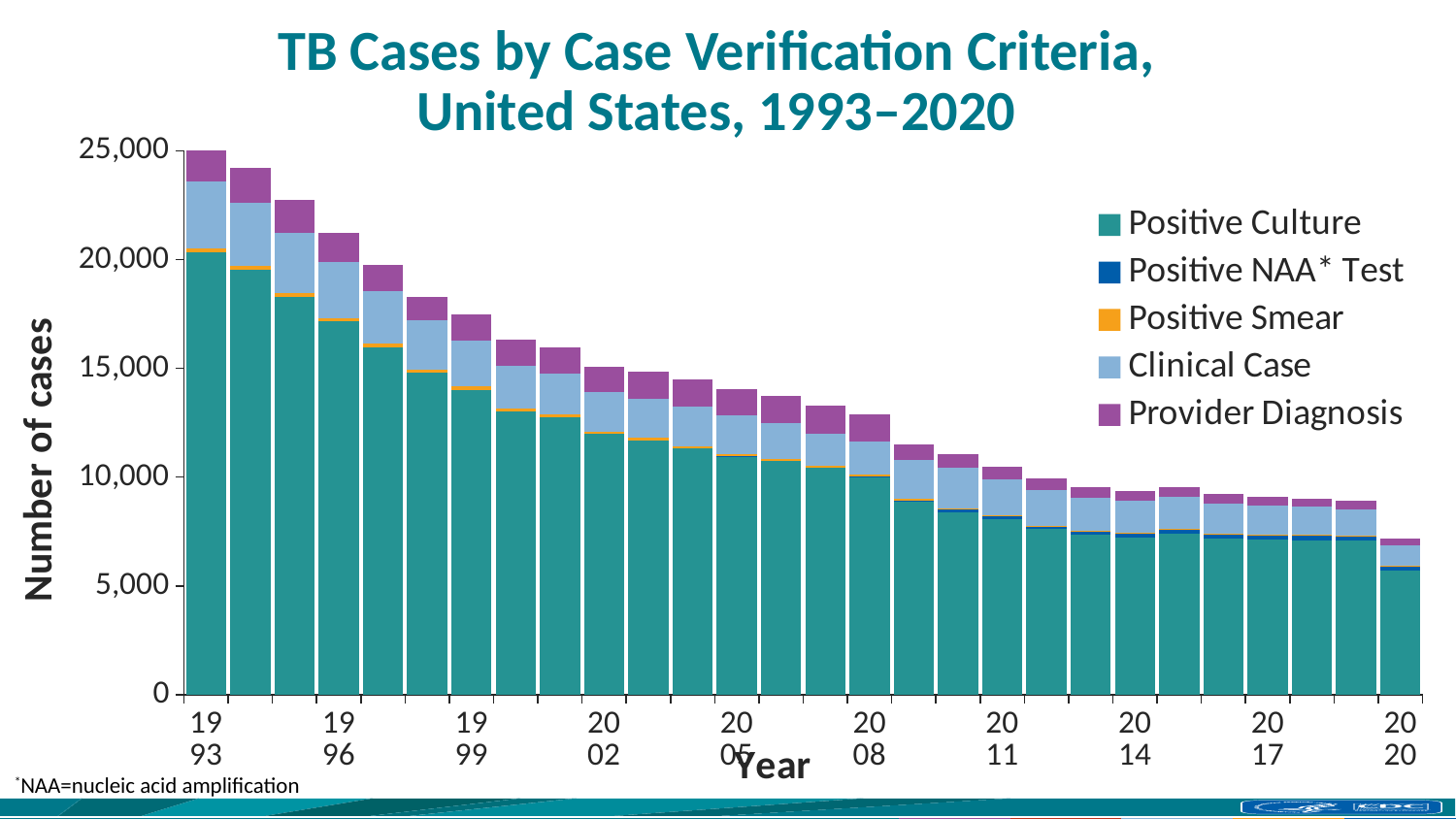
What does the footnote say NAA stands for? Nucleic acid amplification Which series is shown at the bottom of each stacked bar? Positive Culture What kind of chart is shown on the slide? Stacked bar chart Which year has the lowest total number of TB cases? 2020 Which year has the highest total number of TB cases? 1993 Is the total number of cases in 1993 greater or less than 20,000? greater How many series does the legend list? 5 Is the total number of cases in 2020 greater or less than 10,000? less How many years (bars) are plotted on the chart? 28 Which year has more total TB cases, 1996 or 2002? 1996 Do the total TB cases generally rise or fall from 1993 to 2020? Fall Is the total number of cases in 2008 greater or less than 15,000? less